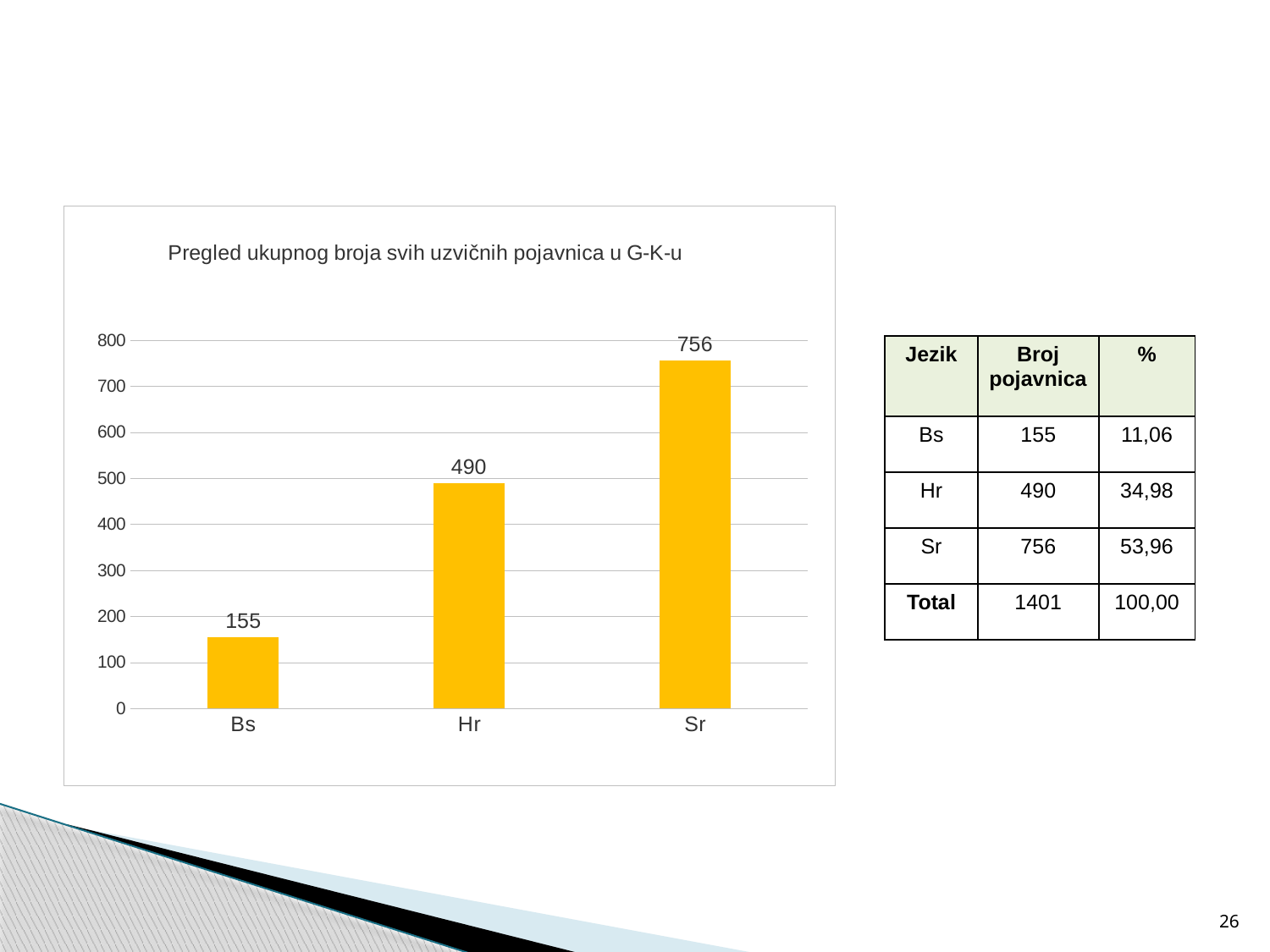
Which category has the highest value in the chart? Sr How many categories are shown on the x axis of the chart? 3 Which is larger, the value for Bs or the value for Hr? Hr What kind of chart is shown on the slide? bar chart What is the difference between the values for Sr and Hr? 266 Is the value for Sr greater or less than 700? greater What is the value for Hr in the chart? 490 Which category has the lowest value in the chart? Bs What is the value for Bs in the chart? 155 What is the difference between the values for Hr and Bs? 335 What is the value for Sr in the chart? 756 What is the title of the chart? Pregled ukupnog broja svih uzvičnih pojavnica u G-K-u